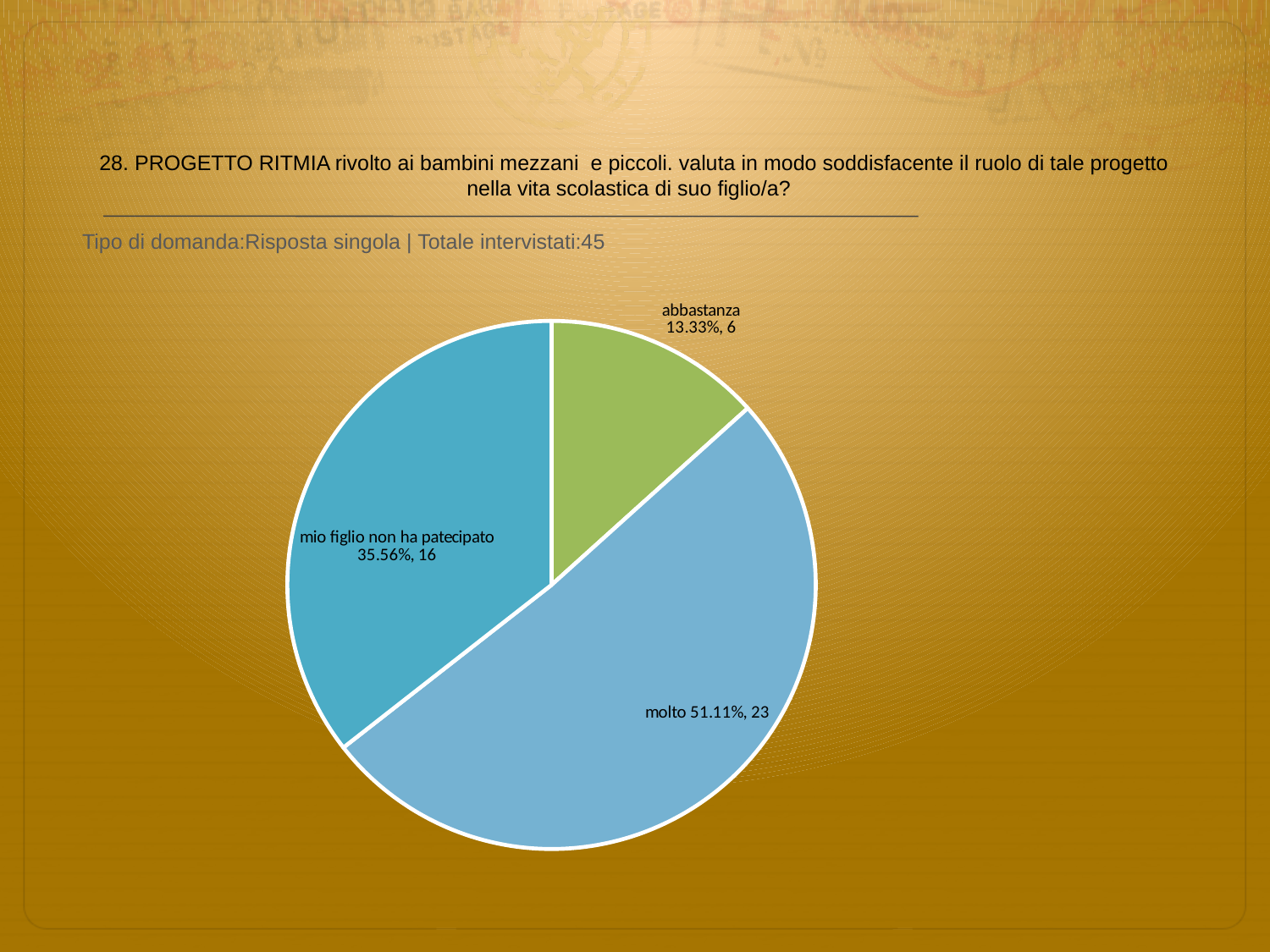
How many respondents answered 'abbastanza'? 6 What kind of chart is shown on the slide? pie chart Which category has the largest slice? molto How many slices does the pie chart have? 3 What colour is the 'abbastanza' slice? green What is the difference in respondent count between 'molto' and 'mio figlio non ha patecipato'? 7 What percentage share does the 'abbastanza' slice have? 13.33% What percentage share does the 'molto' slice have? 51.11% What is the total number of respondents across all slices? 45 Which has more respondents, 'abbastanza' or 'mio figlio non ha patecipato'? mio figlio non ha patecipato Which category has the smallest slice? abbastanza How many respondents answered 'mio figlio non ha patecipato'? 16